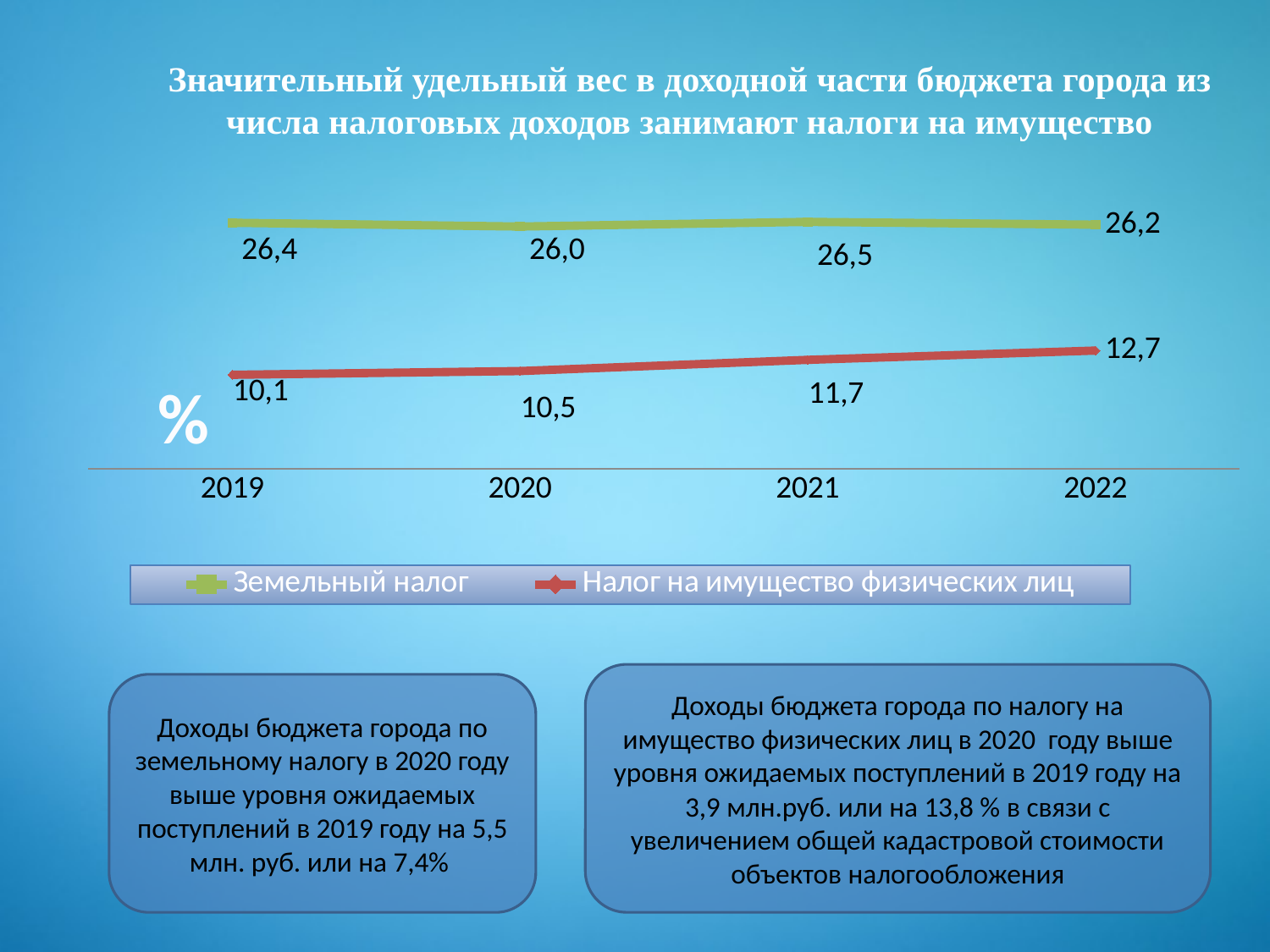
What is the difference between Налог на имущество физических лиц in 2022 and in 2019? 2,6 Does Налог на имущество физических лиц rise or fall from 2019 to 2022? rise In which year is Налог на имущество физических лиц lowest? 2019 What is the value for Налог на имущество физических лиц in 2021? 11,7 What is the value for Земельный налог in 2019? 26,4 What colour is the line for Земельный налог? green In which year is Земельный налог highest? 2021 How many series does the legend list? 2 Which is larger in 2020: Земельный налог or Налог на имущество физических лиц? Земельный налог What kind of chart is shown on the slide? line chart How many years are shown on the x axis? 4 What is the value for Налог на имущество физических лиц in 2022? 12,7